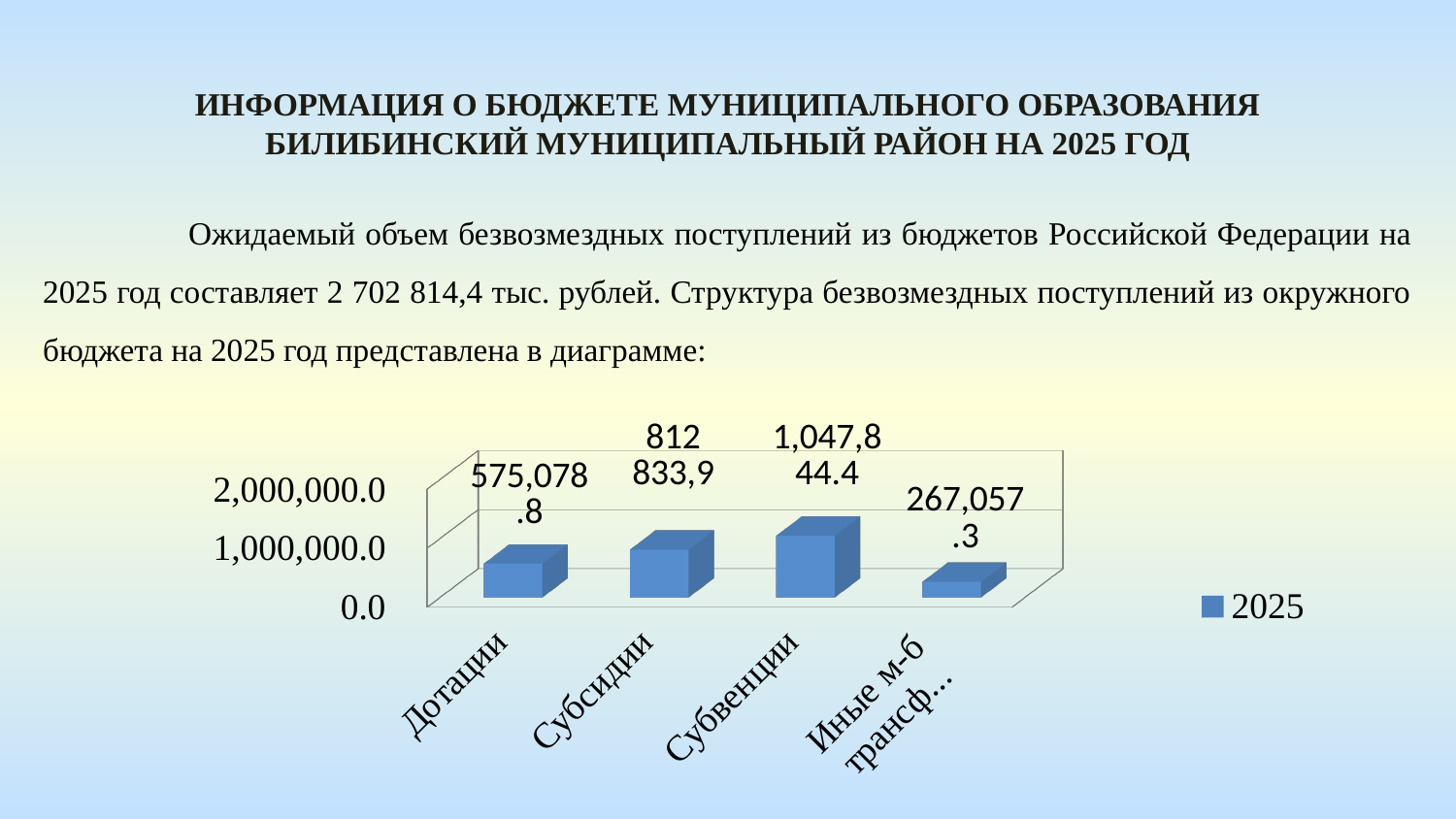
Is the value for Дотации greater or less than 1,000,000.0? less Which category has the lowest value? Иные м-б трансф... How many categories are shown on the chart? 4 Is the value for Субвенции greater or less than 1,000,000.0? greater Which is larger, the value for Дотации or the value for Субсидии? Субсидии Which category has the highest value? Субвенции What is the value for the fourth category, Иные м-б трансф...? 267,057.3 What kind of chart is shown on the slide? bar chart What is the difference between the values for Субвенции and Дотации? 472,765.6 What is the value for Дотации? 575,078.8 What is the value for Субвенции? 1,047,844.4 How many series does the legend list? 1